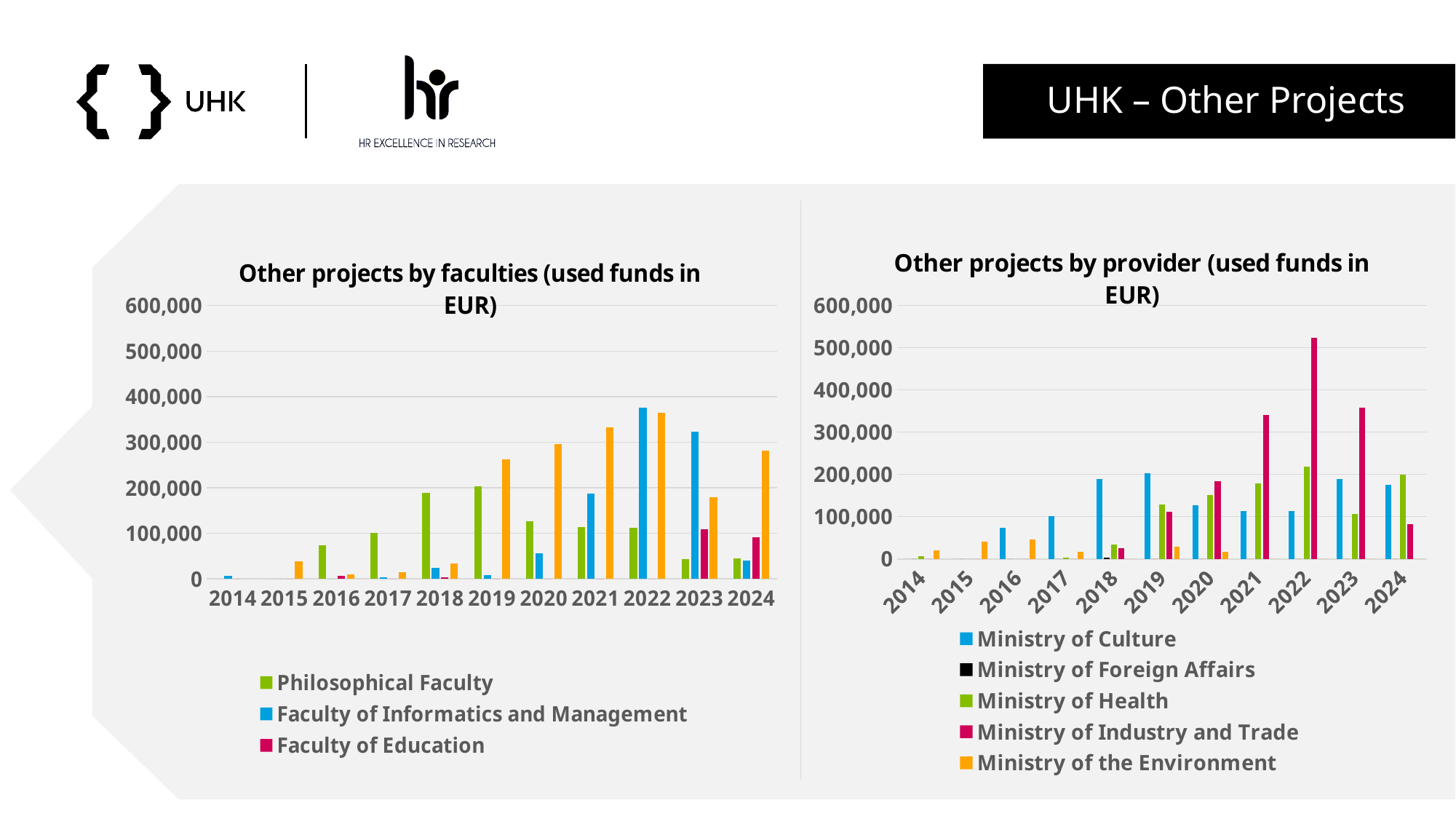
In the 'Other projects by provider (used funds in EUR)' chart, which colour represents Ministry of the Environment? orange What kind of chart is the 'Other projects by faculties (used funds in EUR)' chart? bar chart In the 'Other projects by faculties (used funds in EUR)' chart, in which year is the Faculty of Education bar highest? 2023 How many years are shown on the x axis of the 'Other projects by faculties (used funds in EUR)' chart? 11 In the 'Other projects by provider (used funds in EUR)' chart, which is larger for Ministry of Culture: 2018 or 2017? 2018 In the 'Other projects by faculties (used funds in EUR)' chart, is the value for Philosophical Faculty in 2019 greater or less than 100,000? greater In the 'Other projects by faculties (used funds in EUR)' chart, which is larger for Faculty of Informatics and Management: 2022 or 2021? 2022 In the 'Other projects by provider (used funds in EUR)' chart, in which year is the Ministry of Industry and Trade bar highest? 2022 In the 'Other projects by provider (used funds in EUR)' chart, is the value for Ministry of Industry and Trade in 2022 greater or less than 400,000? greater How many series does the legend of the 'Other projects by faculties (used funds in EUR)' chart list? 3 In the 'Other projects by faculties (used funds in EUR)' chart, is the value for Faculty of Informatics and Management in 2022 greater or less than 300,000? greater How many series does the legend of the 'Other projects by provider (used funds in EUR)' chart list? 5